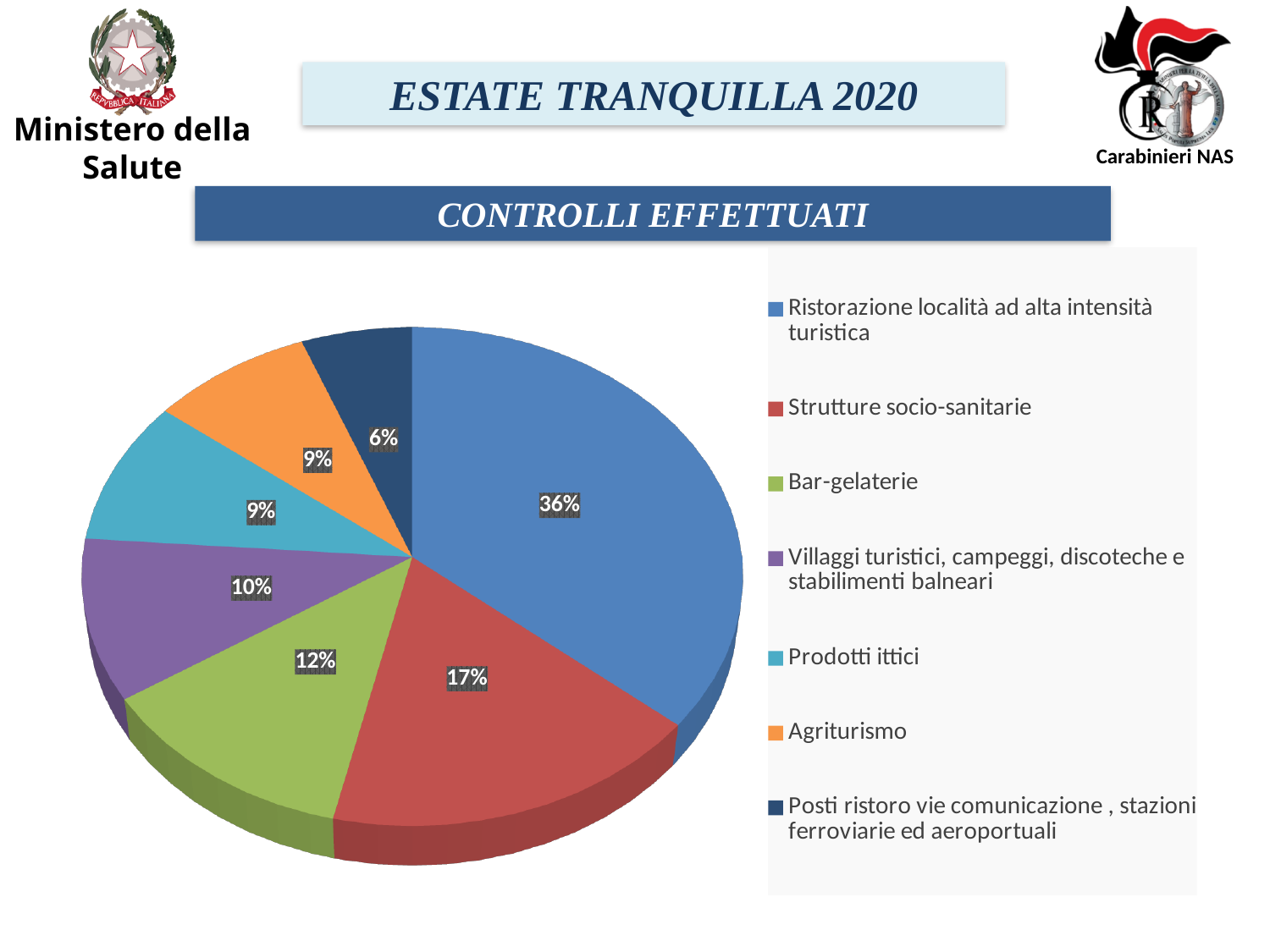
What is the value shown for 'Strutture socio-sanitarie'? 17% What is the difference in percentage points between 'Ristorazione località ad alta intensità turistica' and 'Strutture socio-sanitarie'? 19 What is the title shown in the banner above the chart? CONTROLLI EFFETTUATI How many categories does the pie chart have? 7 Which category has the smallest slice of the pie? Posti ristoro vie comunicazione, stazioni ferroviarie ed aeroportuali What is the value shown for 'Villaggi turistici, campeggi, discoteche e stabilimenti balneari'? 10% Which category has the largest slice of the pie? Ristorazione località ad alta intensità turistica What is the value shown for 'Posti ristoro vie comunicazione, stazioni ferroviarie ed aeroportuali'? 6% Which is larger, the slice for 'Bar-gelaterie' or the slice for 'Agriturismo'? Bar-gelaterie What is the value shown for 'Bar-gelaterie'? 12% What kind of chart is shown on the slide? pie chart What share of the pie does 'Ristorazione località ad alta intensità turistica' represent? 36%